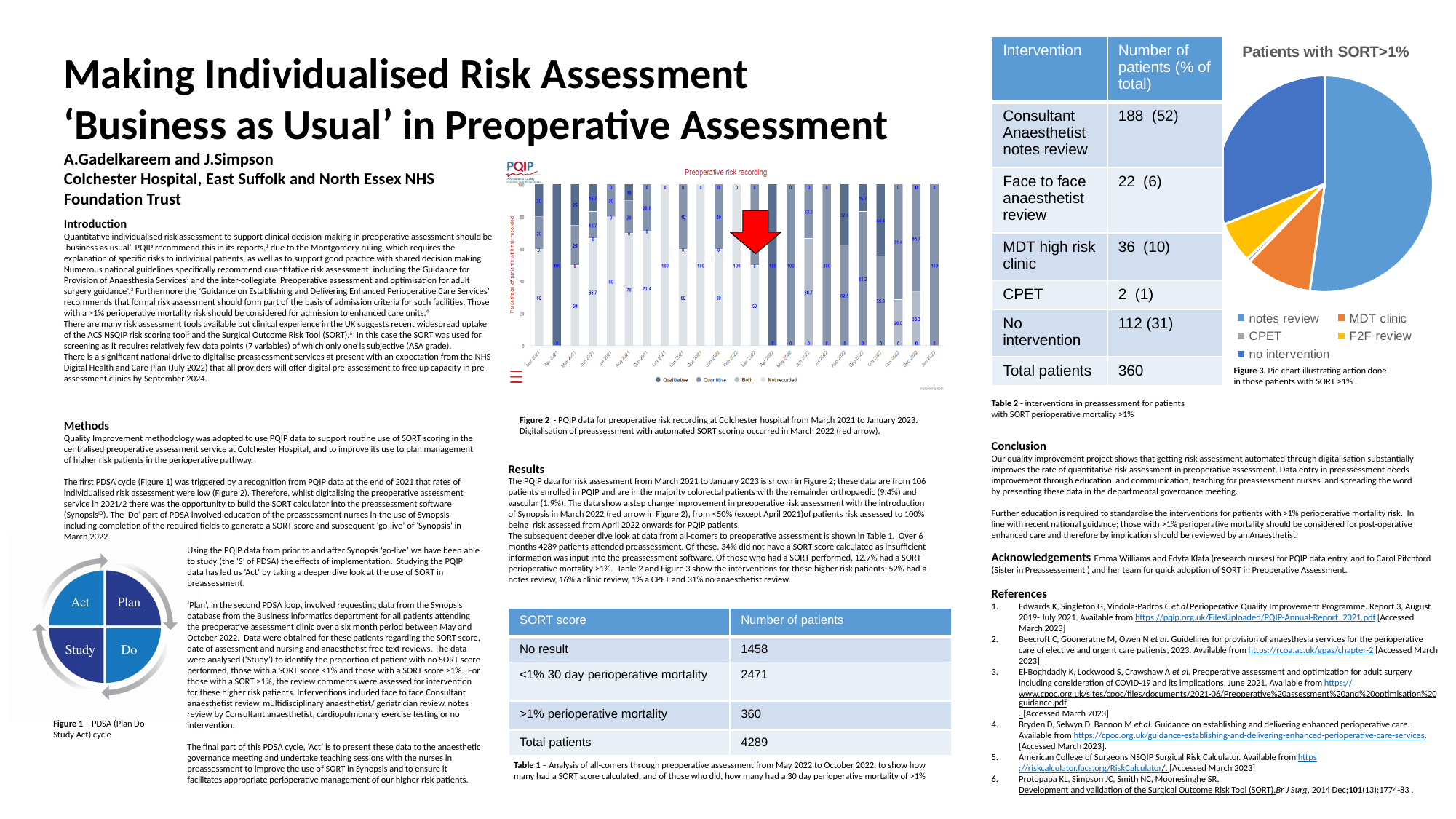
What is the title of the pie chart on the right of the slide? Patients with SORT>1% In the 'Patients with SORT>1%' pie chart, which slice is larger: no intervention or F2F review? no intervention How many entries does the legend of the 'Patients with SORT>1%' pie chart list? 5 How many entries does the legend of the 'Preoperative risk recording' chart in Figure 2 list? 4 In the 'Patients with SORT>1%' pie chart, which category has the smallest slice? CPET In the 'Patients with SORT>1%' pie chart, which slice is larger: notes review or MDT clinic? notes review How many slices does the 'Patients with SORT>1%' pie chart have? 5 What kind of chart is the 'Preoperative risk recording' chart in Figure 2? bar chart In the 'Patients with SORT>1%' pie chart, what colour is the MDT clinic slice? orange In the 'Patients with SORT>1%' pie chart, which slice is larger: MDT clinic or CPET? MDT clinic In the 'Patients with SORT>1%' pie chart, which category has the largest slice? notes review What kind of chart is the 'Patients with SORT>1%' chart? pie chart